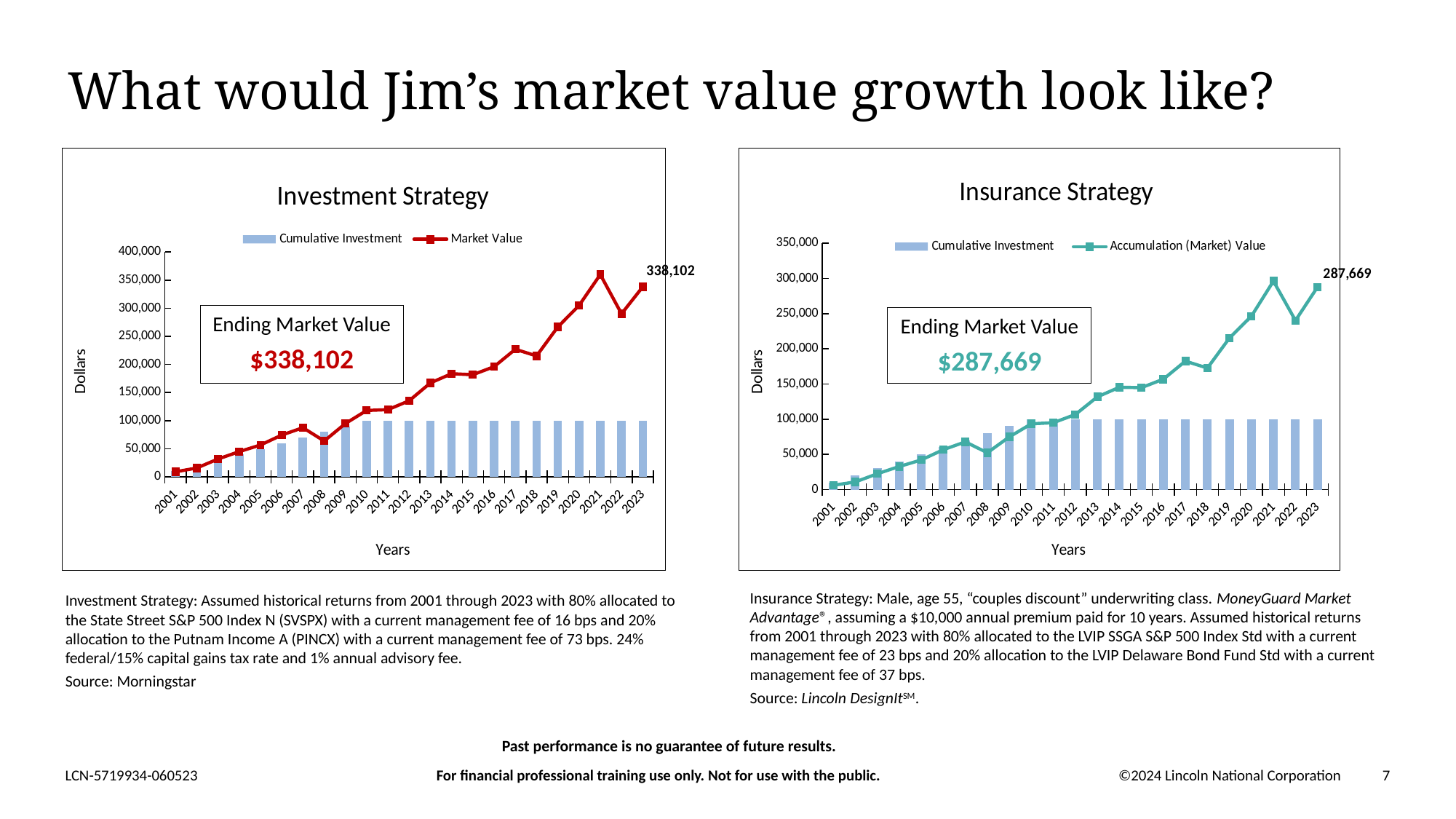
How many series does the legend of the Insurance Strategy chart list? 2 In the Insurance Strategy chart, which year has the lowest Accumulation (Market) Value? 2001 In the Insurance Strategy chart, what is the Accumulation (Market) Value labelled for 2023? 287,669 In the Insurance Strategy chart, what is the name of the line series in the legend? Accumulation (Market) Value How many years are shown on the x axis of the Investment Strategy chart? 23 In the Investment Strategy chart, what is the Market Value labelled for 2023? 338,102 Which chart shows the larger ending market value, Investment Strategy or Insurance Strategy? Investment Strategy In the Investment Strategy chart, is the Market Value for 2021 greater or less than 300,000? greater In the Investment Strategy chart, which year has the highest Market Value? 2021 What is the difference between the ending market value in the Investment Strategy chart and the ending market value in the Insurance Strategy chart? 50,433 What kind of chart is the Investment Strategy chart? Combination bar and line chart In the Insurance Strategy chart, does the Accumulation (Market) Value generally rise or fall from 2001 to 2023? Rise